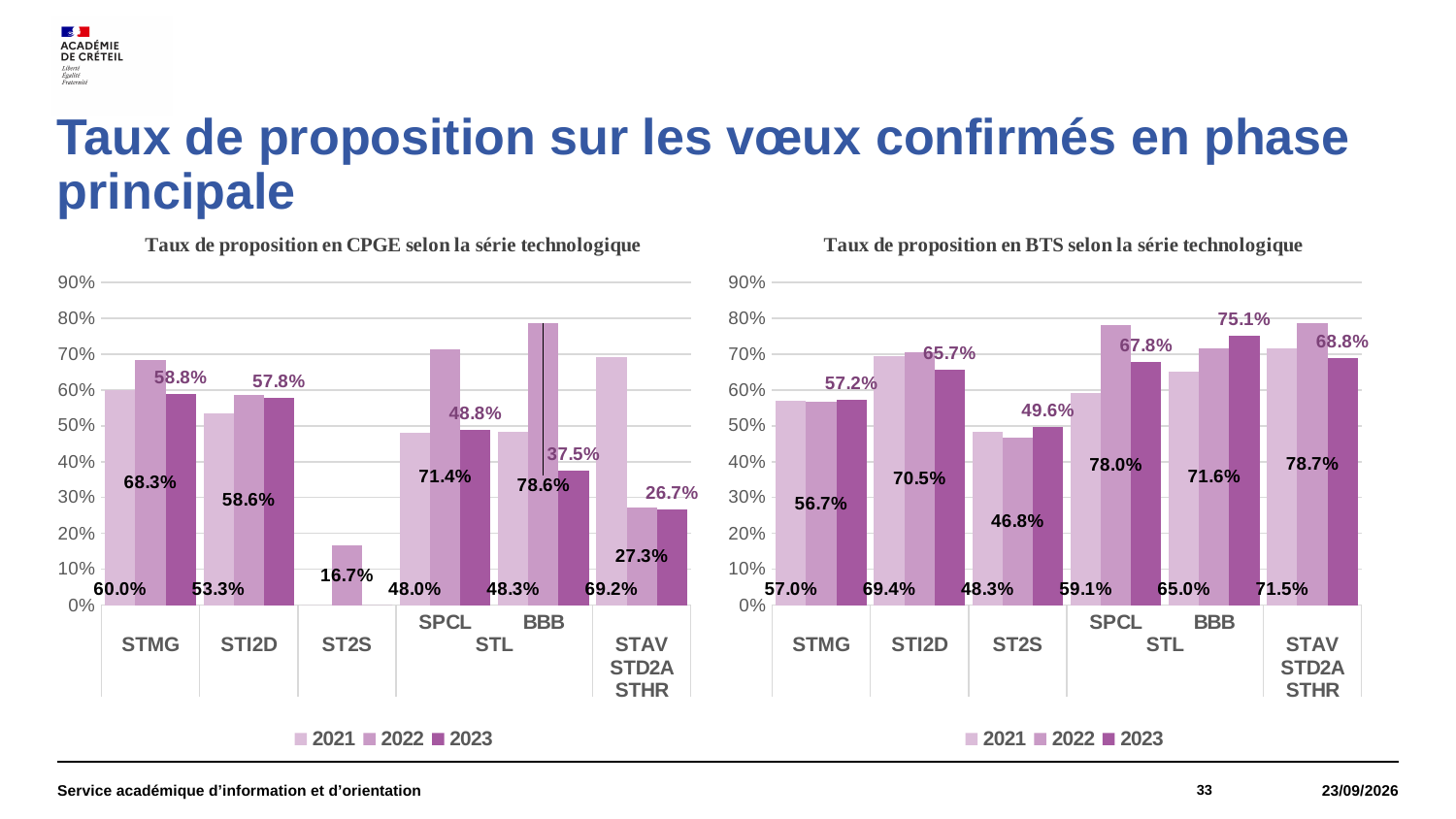
In the 'Taux de proposition en BTS selon la série technologique' chart, which category has the highest value for 2023? STL BBB In the 'Taux de proposition en BTS selon la série technologique' chart, do the values for STL BBB rise or fall from 2021 to 2023? rise In the 'Taux de proposition en CPGE selon la série technologique' chart, what is the value for STMG in 2022? 68.3% In the 'Taux de proposition en CPGE selon la série technologique' chart, what is the value for ST2S in 2022? 16.7% In the 'Taux de proposition en BTS selon la série technologique' chart, what is the value for STL BBB in 2023? 75.1% In the 'Taux de proposition en BTS selon la série technologique' chart, what is the value for ST2S in 2022? 46.8% In the 'Taux de proposition en BTS selon la série technologique' chart, what is the difference between the 2022 and 2021 values for STL SPCL? 18.9 percentage points How many series does the legend of the 'Taux de proposition en BTS selon la série technologique' chart list? 3 How many categories are shown on the x axis of the 'Taux de proposition en BTS selon la série technologique' chart? 6 In the 'Taux de proposition en CPGE selon la série technologique' chart, which is larger for 2021: STMG or STI2D? STMG What kind of chart is the 'Taux de proposition en CPGE selon la série technologique' chart? bar chart